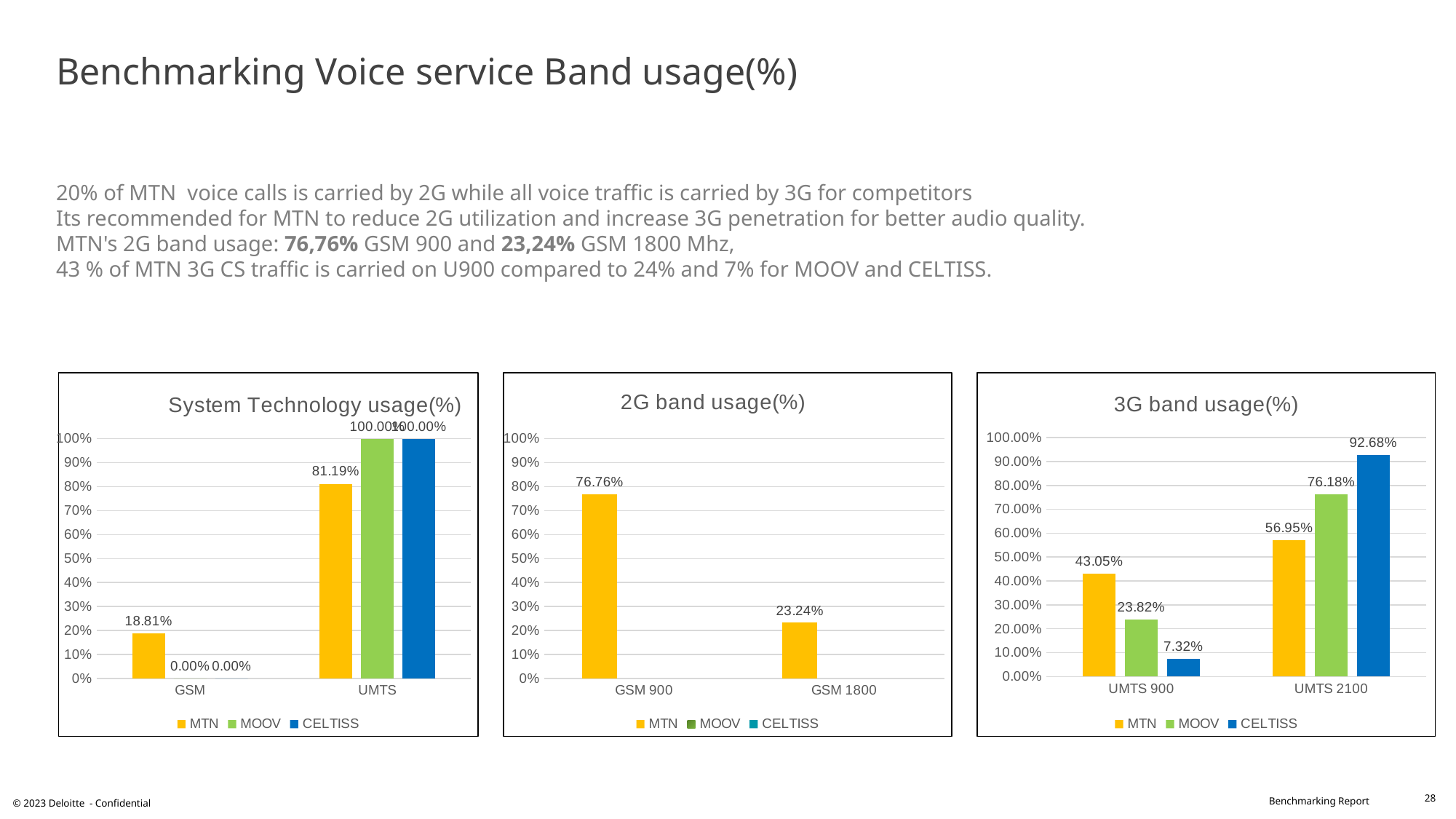
In the '3G band usage(%)' chart, what is the difference between the MOOV values for UMTS 2100 and UMTS 900? 52.36% In the '3G band usage(%)' chart, which operator has the highest value at UMTS 2100? CELTISS In the '2G band usage(%)' chart, what is the difference between the MTN values for GSM 900 and GSM 1800? 53.52% What kind of chart is the '2G band usage(%)' chart? Bar chart How many series does the legend of the '3G band usage(%)' chart list? 3 In the 'System Technology usage(%)' chart, what is the value for MTN in the UMTS category? 81.19% In the 'System Technology usage(%)' chart, what is the value for MTN in the GSM category? 18.81% In the '2G band usage(%)' chart, what is the value for MTN at GSM 1800? 23.24% In the '3G band usage(%)' chart, what is the value for CELTISS at UMTS 900? 7.32% In the '2G band usage(%)' chart, what is the value for MTN at GSM 900? 76.76% In the 'System Technology usage(%)' chart, what is the value for MOOV in the GSM category? 0.00% In the '3G band usage(%)' chart, which operator has the lowest value at UMTS 900? CELTISS